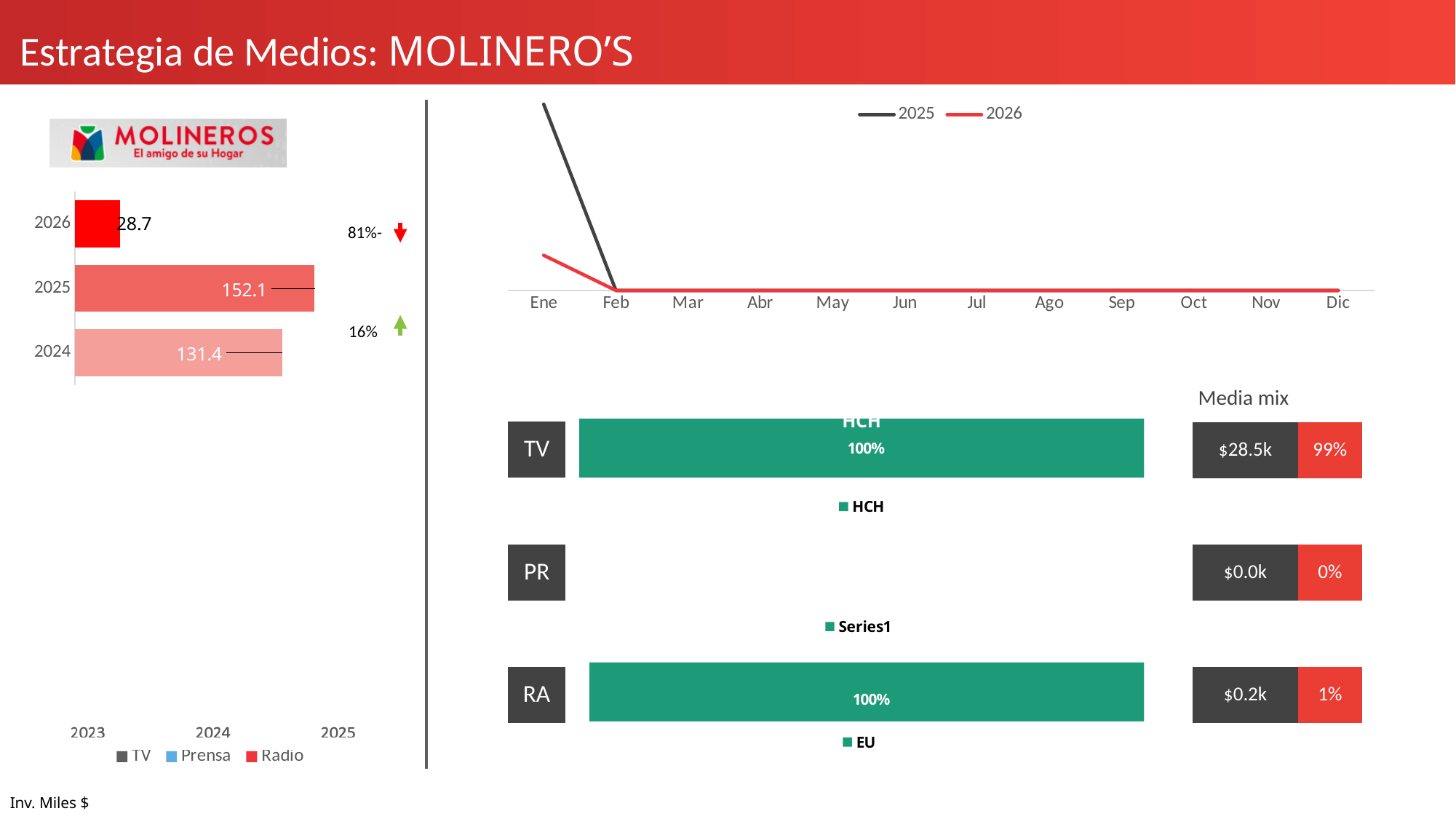
In the bar chart on the left, which is larger, the value for 2024 or the value for 2026? 2024 In the bar chart on the left, what is the difference between the 2025 and 2024 values? 20.7 In the bar chart on the left, which year has the highest value? 2025 In the bar chart on the left, which year has the lowest value? 2026 In the bar chart on the left, what is the value for 2026? 28.7 What kind of chart is the chart on the left showing the years 2024, 2025 and 2026? bar chart In the bar chart on the left, what is the value for 2024? 131.4 In the line chart at the top right, how many series does the legend list? 2 In the Media mix section on the right, what percentage is shown for TV? 99% In the bar chart on the left, what is the value for 2025? 152.1 In the line chart at the top right, how many months are shown on the x axis? 12 In the line chart at the top right, does the 2025 line rise or fall from Ene to Feb? fall